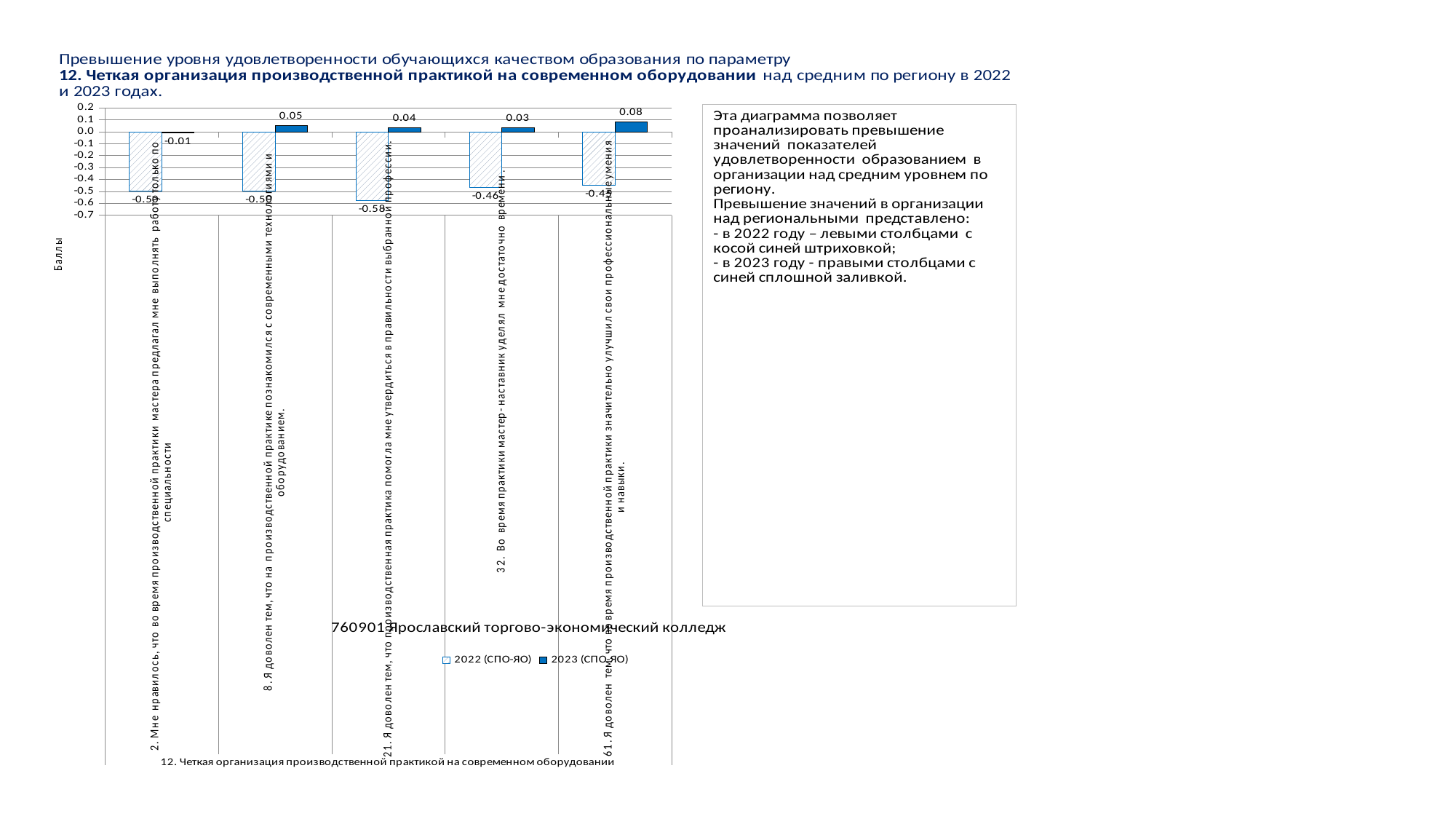
What is the 2023 (СПО-ЯО) value for category 2 ("Мне нравилось, что во время производственной практики мастера предлагал мне выполнять работу только по специальности")? -0.01 How many series does the chart legend list? 2 What type of chart is shown on the slide? bar chart What is the 2023 (СПО-ЯО) value for category 21 ("Я доволен тем, что производственная практика помогла мне утвердиться в правильности выбранной профессии")? 0.04 What is the 2022 (СПО-ЯО) value for category 32 ("Во время практики мастер-наставник уделял мне достаточно времени")? -0.46 How many categories (questions) are plotted on the chart? 5 Is the 2022 (СПО-ЯО) value for category 8 greater or less than -0.3? less What is the 2022 (СПО-ЯО) value for category 21 ("Я доволен тем, что производственная практика помогла мне утвердиться в правильности выбранной профессии")? -0.58 Which series is shown with a solid blue fill according to the legend? 2023 (СПО-ЯО) What is the difference between the 2023 and 2022 values for category 21? 0.62 Which category has the lowest 2022 (СПО-ЯО) value? 21. Я доволен тем, что производственная практика помогла мне утвердиться в правильности выбранной профессии Which category has the highest 2023 (СПО-ЯО) value? 61. Я доволен тем, что во время производственной практики значительно улучшил свои профессиональные умения и навыки